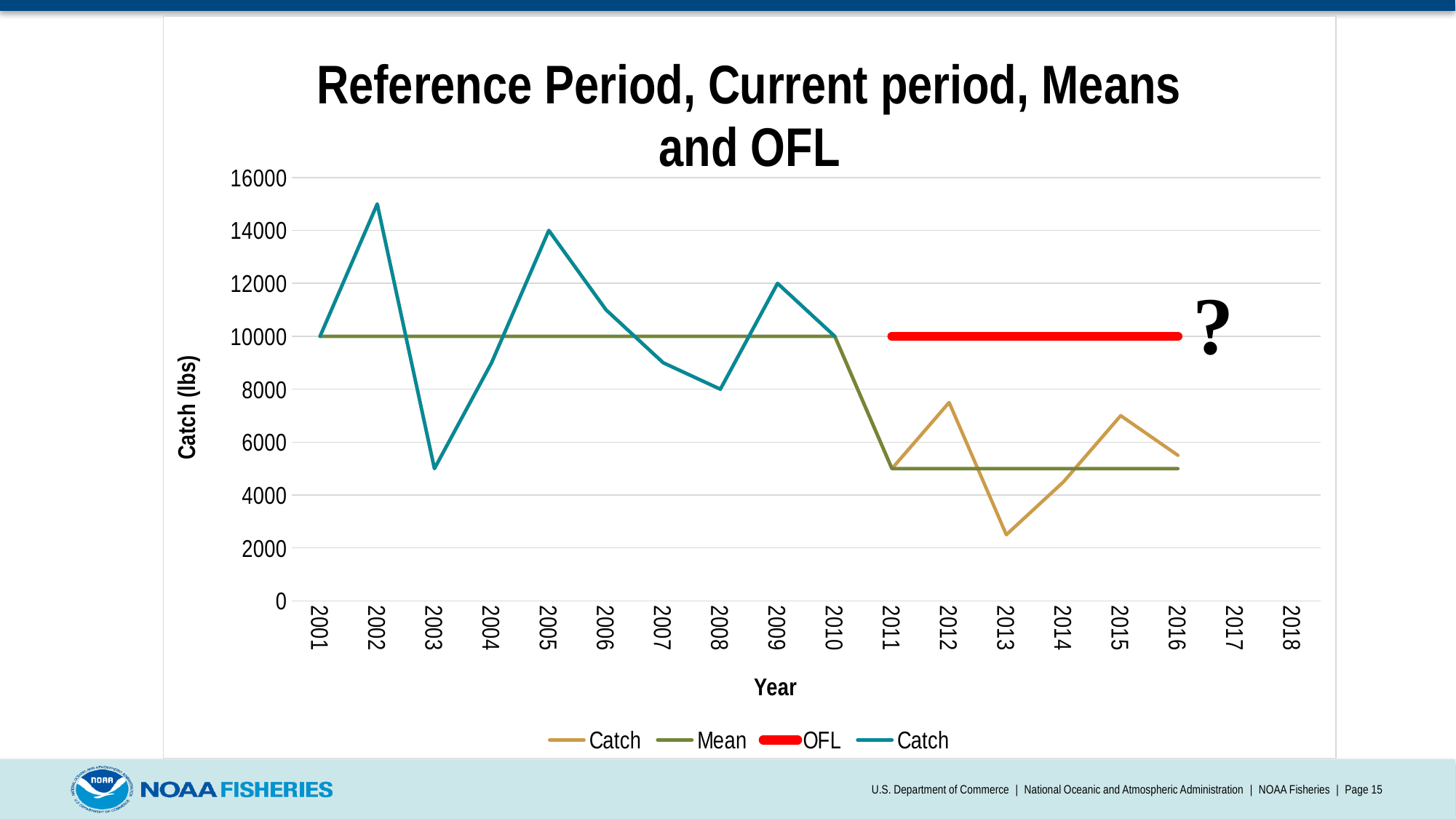
What is the OFL value shown for 2011 to 2016? 10000 Which year has the highest catch? 2002 Which year has the lowest catch? 2013 What kind of chart is shown on the slide? line chart What is the catch value for 2009? 12000 Is the catch value for 2013 greater or less than 4000? less What is the catch value for 2005? 14000 Does the catch rise or fall from 2005 to 2008? fall What is the difference between the catch in 2005 and the catch in 2008? 6000 Is the catch value for 2002 greater or less than 14000? greater What is the catch value for 2008? 8000 How many series does the legend list? 4